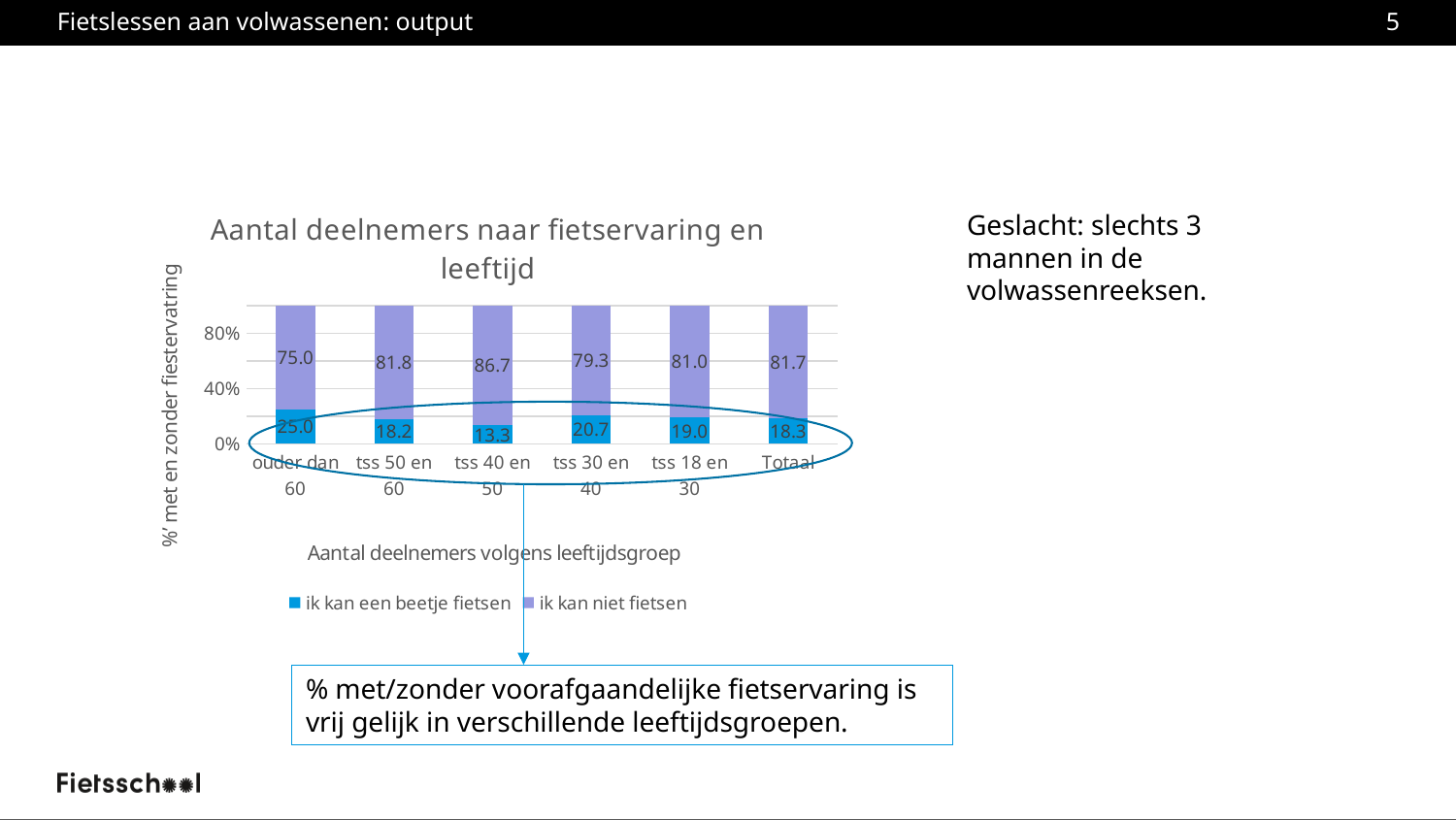
What is the value for 'ik kan niet fietsen' in the 'tss 40 en 50' category? 86.7 How many categories are shown on the x axis? 6 Which is larger: the 'ik kan een beetje fietsen' value for 'tss 30 en 40' or for 'tss 50 en 60'? tss 30 en 40 What kind of chart is shown on the slide? stacked bar chart What is the value for 'ik kan een beetje fietsen' in the 'Totaal' category? 18.3 What is the difference between the 'ik kan niet fietsen' values for 'tss 40 en 50' and 'ouder dan 60'? 11.7 Which category has the highest value for 'ik kan een beetje fietsen'? ouder dan 60 How many series does the legend list? 2 Which category has the lowest value for 'ik kan een beetje fietsen'? tss 40 en 50 What is the value for 'ik kan een beetje fietsen' in the 'ouder dan 60' category? 25.0 What is the title of the chart? Aantal deelnemers naar fietservaring en leeftijd Which category has the highest value for 'ik kan niet fietsen'? tss 40 en 50